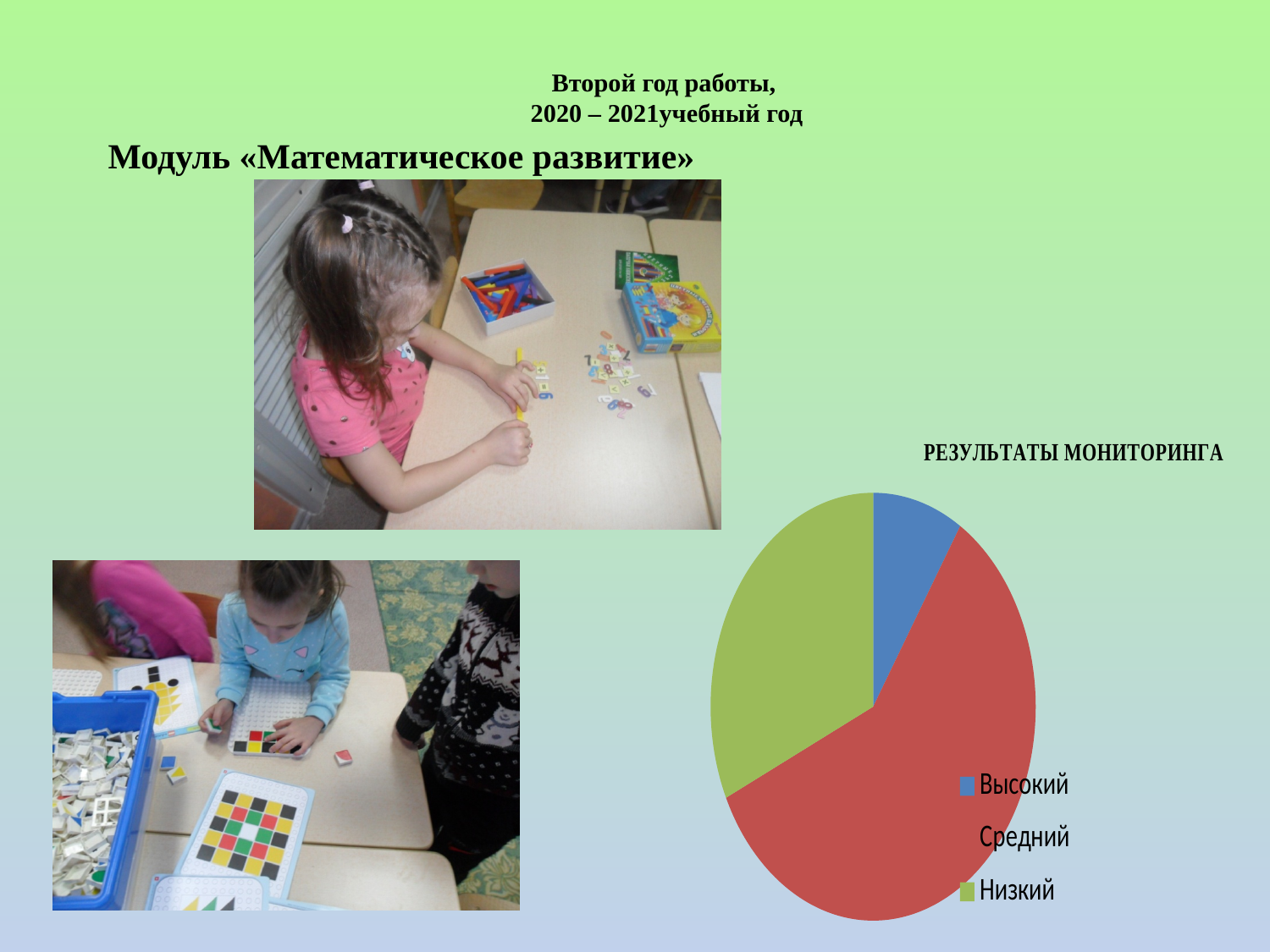
How many slices does the pie chart have? 3 Which category has the smallest slice in the pie chart? Высокий What kind of chart is shown on the slide? pie chart Which slice is larger in the pie chart, Низкий or Высокий? Низкий What is the title of the pie chart? РЕЗУЛЬТАТЫ МОНИТОРИНГА Which category has the largest slice in the pie chart? Средний What colour is the Высокий slice in the pie chart? blue Which category in the pie chart is shown in green? Низкий How many entries does the legend of the pie chart list? 3 Which slice is larger in the pie chart, Средний or Низкий? Средний